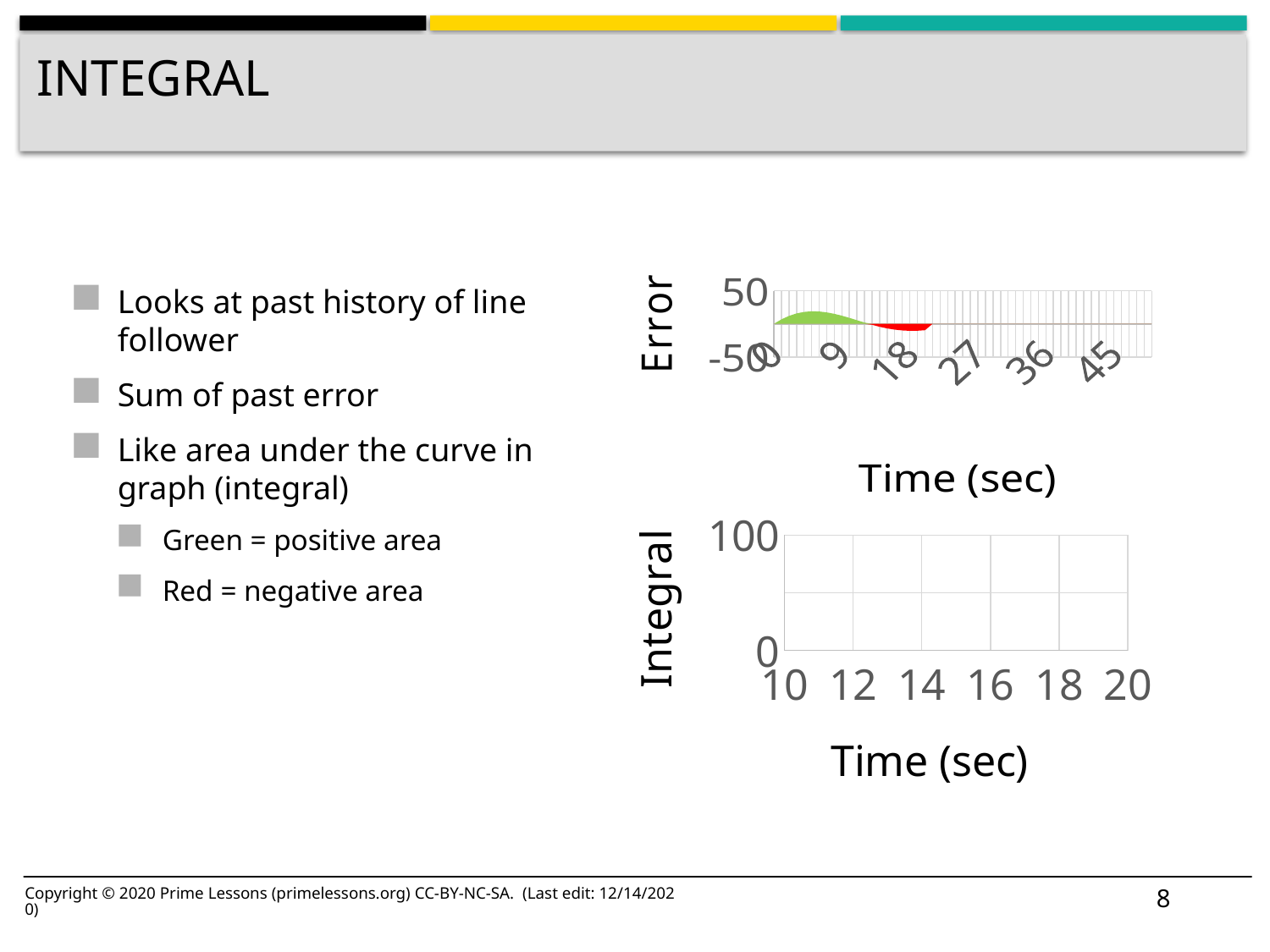
In the top chart, what is the label on the vertical axis? Error In the top chart, how many tick labels are shown on the Time (sec) axis? 6 In the top chart, what is the lowest value labelled on the Error axis? -50 In the top chart, is the error value at time 14 greater or less than -50? greater In the bottom chart, how many tick labels are shown on the Time (sec) axis? 6 In the top chart, does the error rise or fall between time 4 and time 9? fall In the top chart, is the error value at time 4 greater or less than 50? less What kind of chart is the top chart (Error vs Time)? area chart In the bottom chart, what is the label on the vertical axis? Integral In the bottom chart, what is the highest value labelled on the Integral axis? 100 In the top chart, does the error rise or fall between time 0 and time 4? rise